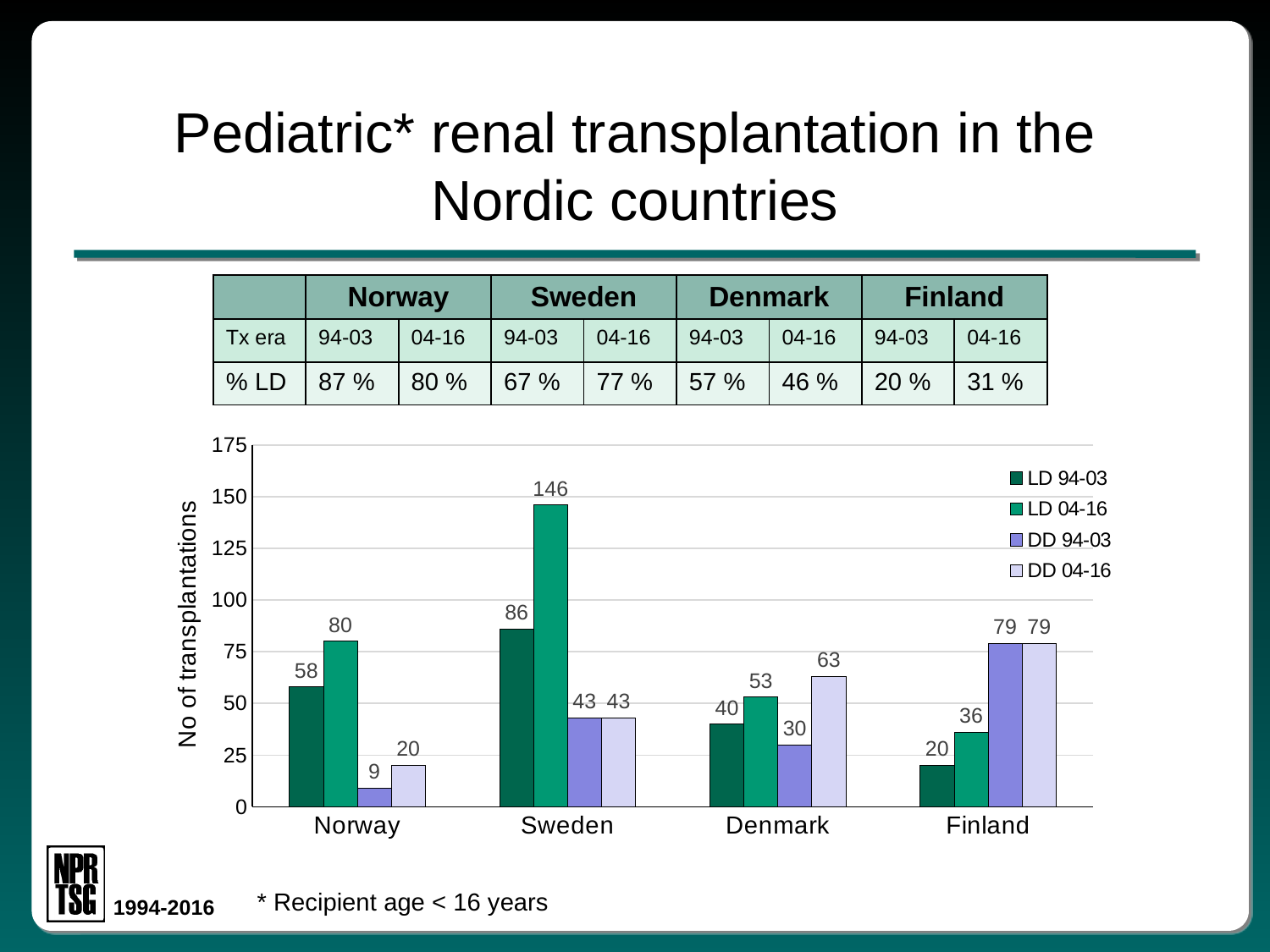
How many countries are shown on the x axis of the chart? 4 Which is larger in Finland: LD 04-16 or DD 04-16? DD 04-16 What is the difference between the LD 04-16 and LD 94-03 values for Sweden? 60 What is the value for LD 94-03 in Finland? 20 Which country has the lowest DD 94-03 value? Norway How many series does the chart legend list? 4 Which country has the highest LD 04-16 value? Sweden What is the label of the y axis of the chart? No of transplantations What is the value for DD 04-16 in Denmark? 63 What is the value for DD 94-03 in Norway? 9 What kind of chart is shown on the slide? Bar chart What is the value for LD 04-16 in Sweden? 146